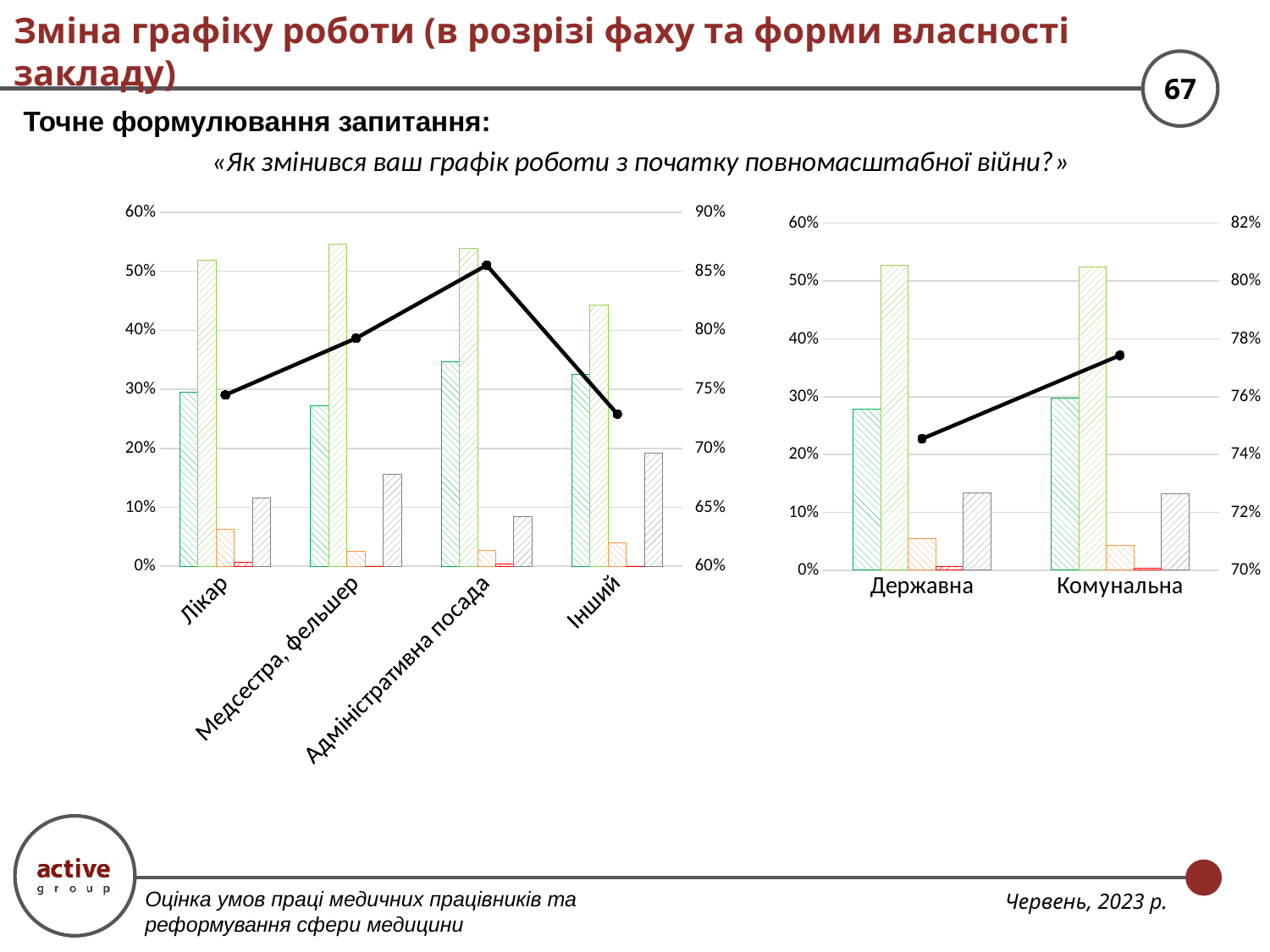
How many categories are shown on the x axis of the left chart? 4 In the left chart, is the line value for Адміністративна посада greater or less than 80% on the right axis? greater In the left chart, for which category does the line reach its highest point? Адміністративна посада How many categories are shown on the x axis of the right chart? 2 In the left chart, which category has the lowest value for the tallest (green hatched) bar series? Інший What is the survey question quoted above the charts? «Як змінився ваш графік роботи з початку повномасштабної війни?» What kind of chart is the left chart? Combination bar and line chart In the left chart, is the line value for Лікар greater or less than 80% on the right axis? less In the right chart, is the line value for Комунальна greater or less than 76% on the right axis? greater In the right chart, does the line rise or fall from Державна to Комунальна? rises